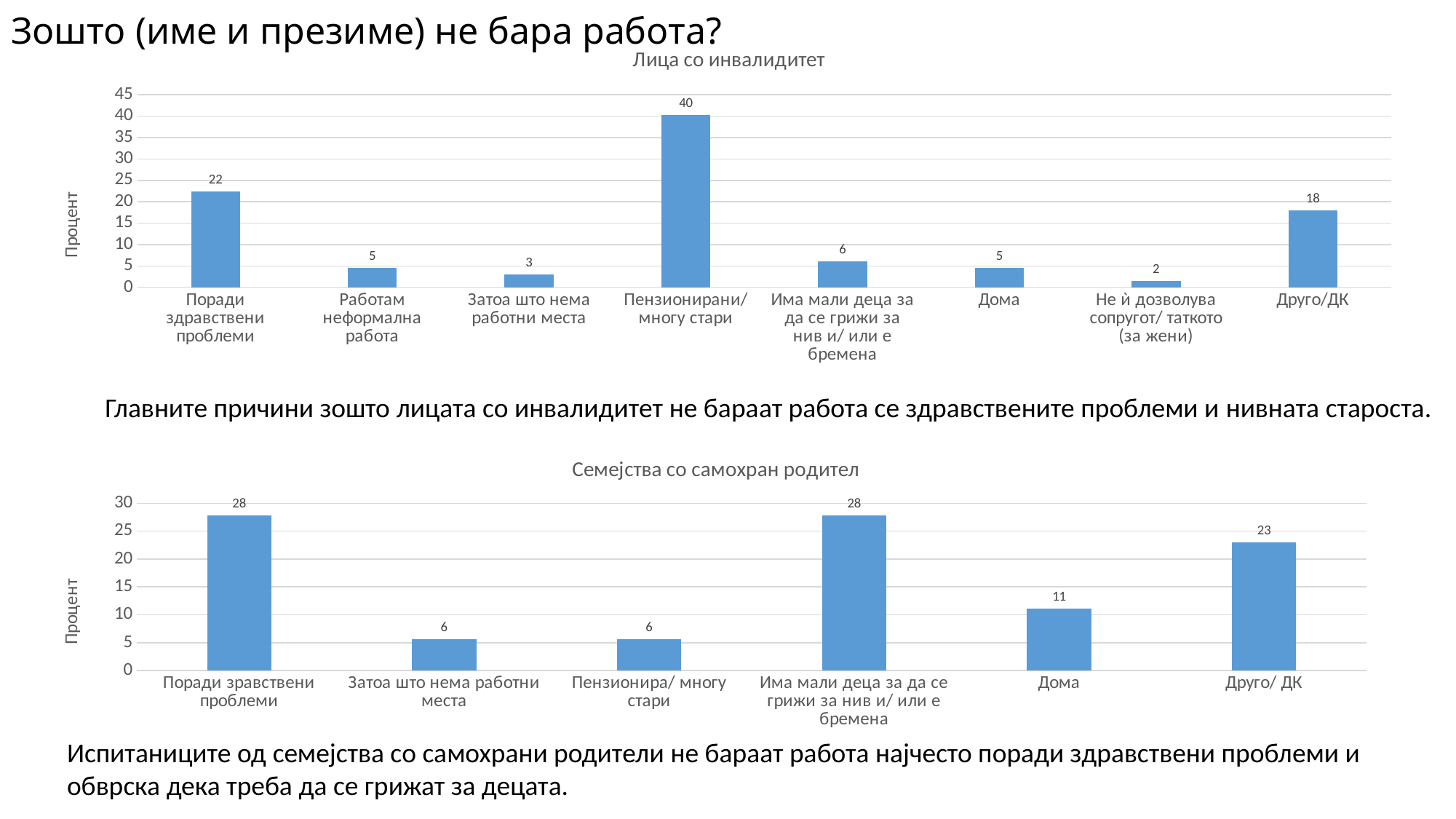
In the 'Семејства со самохран родител' chart, what is the value for 'Дома'? 11 In the 'Семејства со самохран родител' chart, how many categories are shown? 6 In the 'Семејства со самохран родител' chart, which is larger: 'Дома' or 'Друго/ ДК'? Друго/ ДК In the 'Семејства со самохран родител' chart, what is the value for 'Друго/ ДК'? 23 In the 'Семејства со самохран родител' chart, what is the difference between 'Поради зравствени проблеми' and 'Дома'? 17 In the 'Лица со инвалидитет' chart, what is the value for 'Поради здравствени проблеми'? 22 What type of chart is the 'Семејства со самохран родител' chart? Bar chart In the 'Лица со инвалидитет' chart, what is the value for 'Пензионирани/ многу стари'? 40 In the 'Лица со инвалидитет' chart, is the value for 'Друго/ДК' greater or less than 15? greater In the 'Лица со инвалидитет' chart, which category has the lowest value? Не ѝ дозволува сопругот/ таткото (за жени) In the 'Лица со инвалидитет' chart, how many categories are shown? 8 In the 'Лица со инвалидитет' chart, what is the difference between 'Пензионирани/ многу стари' and 'Друго/ДК'? 22